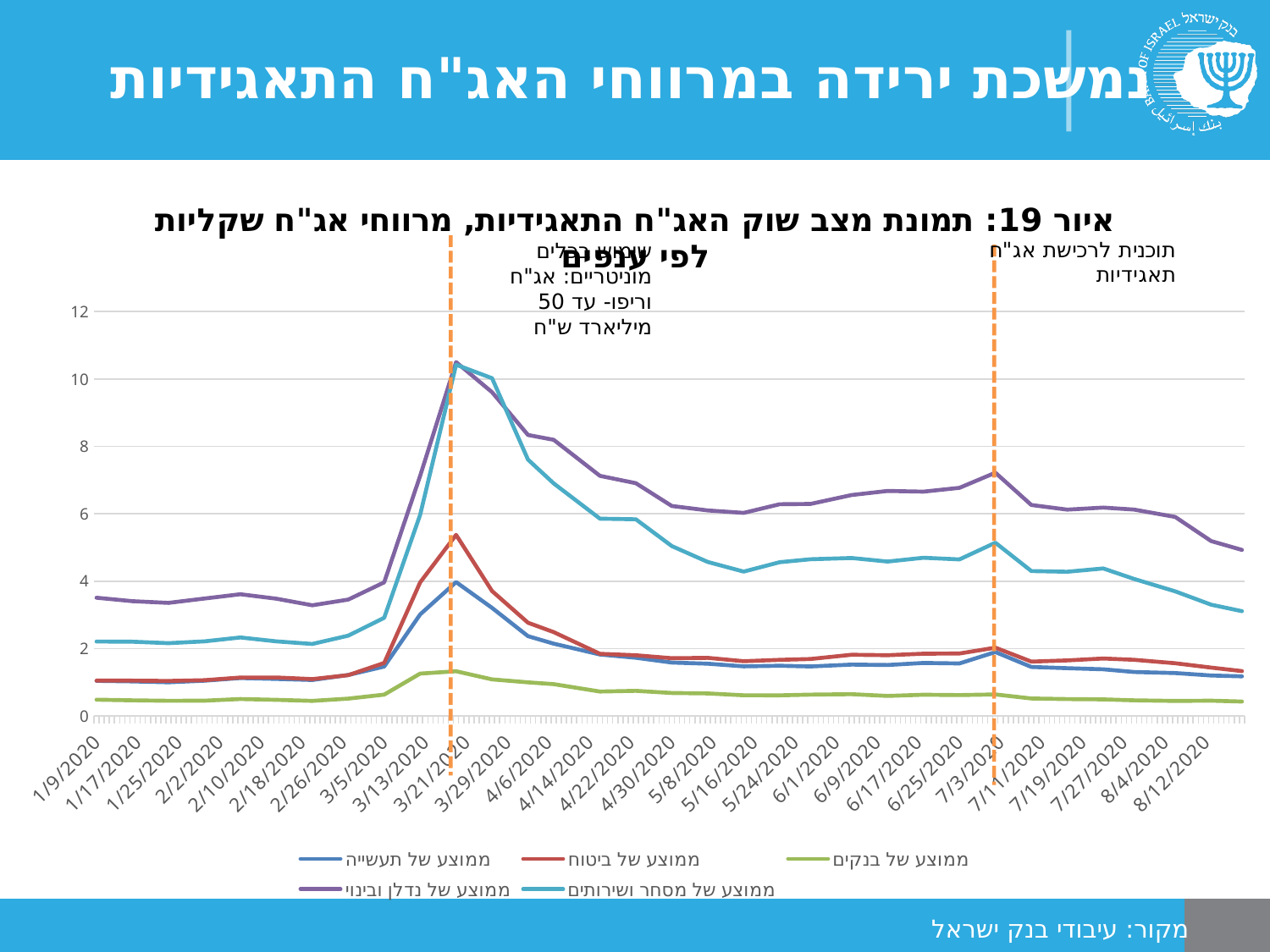
What kind of chart is shown on the slide? line chart At 8/12/2020, which is larger: ממוצע של נדלן ובינוי or ממוצע של מסחר ושירותים? ממוצע של נדלן ובינוי Is the value of ממוצע של מסחר ושירותים at 8/12/2020 greater or less than 4? less Is the value of ממוצע של בנקים at 3/21/2020 greater or less than 2? less Does ממוצע של נדלן ובינוי rise or fall between 3/21/2020 and 8/12/2020? fall What event does the annotation at the dashed line near 7/3/2020 mark? תוכנית לרכישת אג"ח תאגידיות How many series does the legend list? 5 Which series stays lowest across the whole period? ממוצע של בנקים Is the value of ממוצע של נדלן ובינוי at its peak around 3/21/2020 greater or less than 10? greater At 8/12/2020, which is larger: ממוצע של ביטוח or ממוצע של בנקים? ממוצע של ביטוח